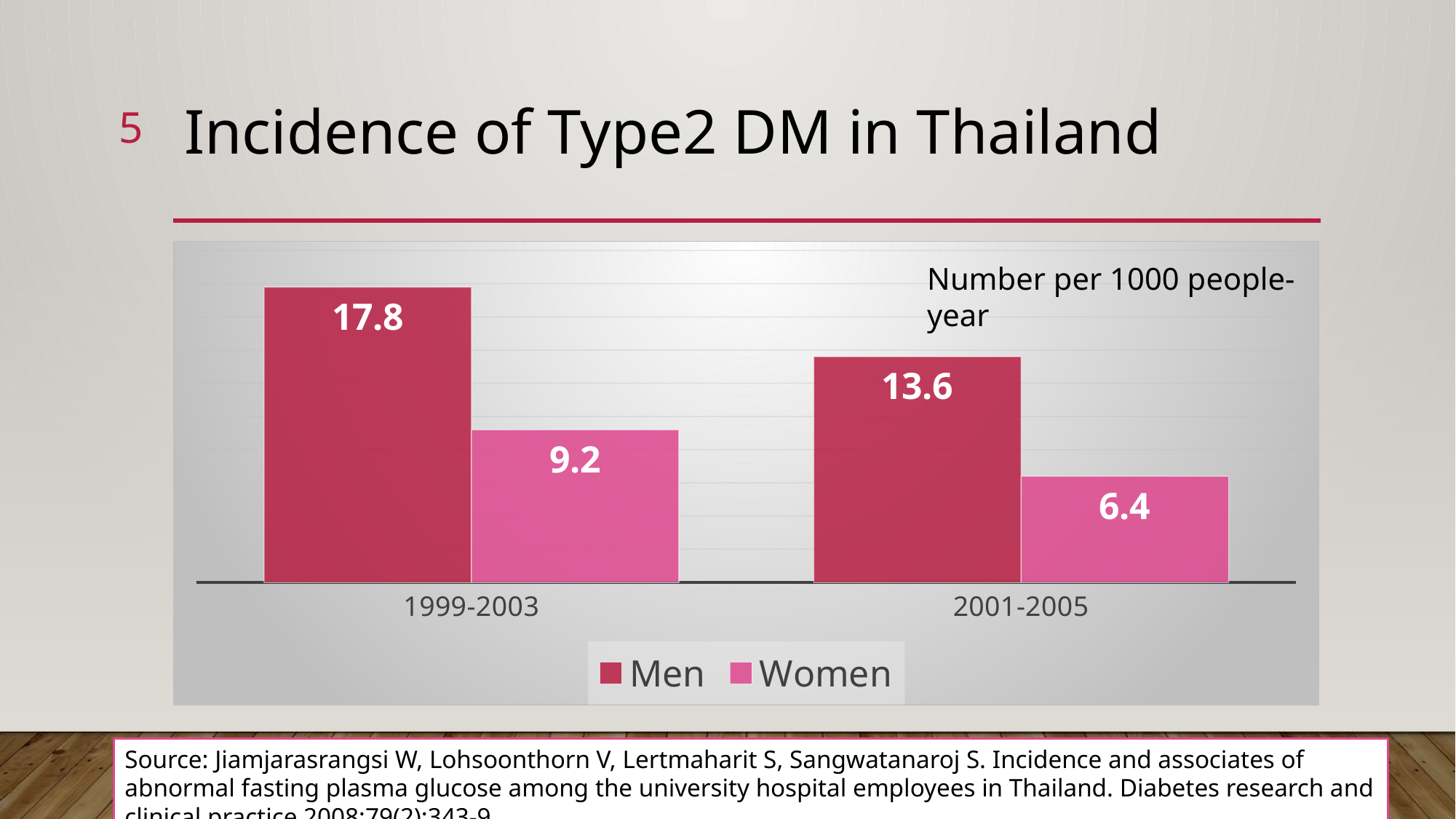
Which is larger: the Women value in 1999-2003 or the Women value in 2001-2005? 1999-2003 What is the value for Women in 1999-2003? 9.2 What is the value for Men in 1999-2003? 17.8 How many period categories are shown on the x axis? 2 What is the difference between the Men and Women values in 1999-2003? 8.6 Which bar has the lowest value on the chart? Women, 2001-2005 Which bar has the highest value on the chart? Men, 1999-2003 What is the value for Men in 2001-2005? 13.6 How many series does the legend list? 2 What kind of chart is shown on the slide? Bar chart What is the difference between the Men values for 1999-2003 and 2001-2005? 4.2 What is the value for Women in 2001-2005? 6.4